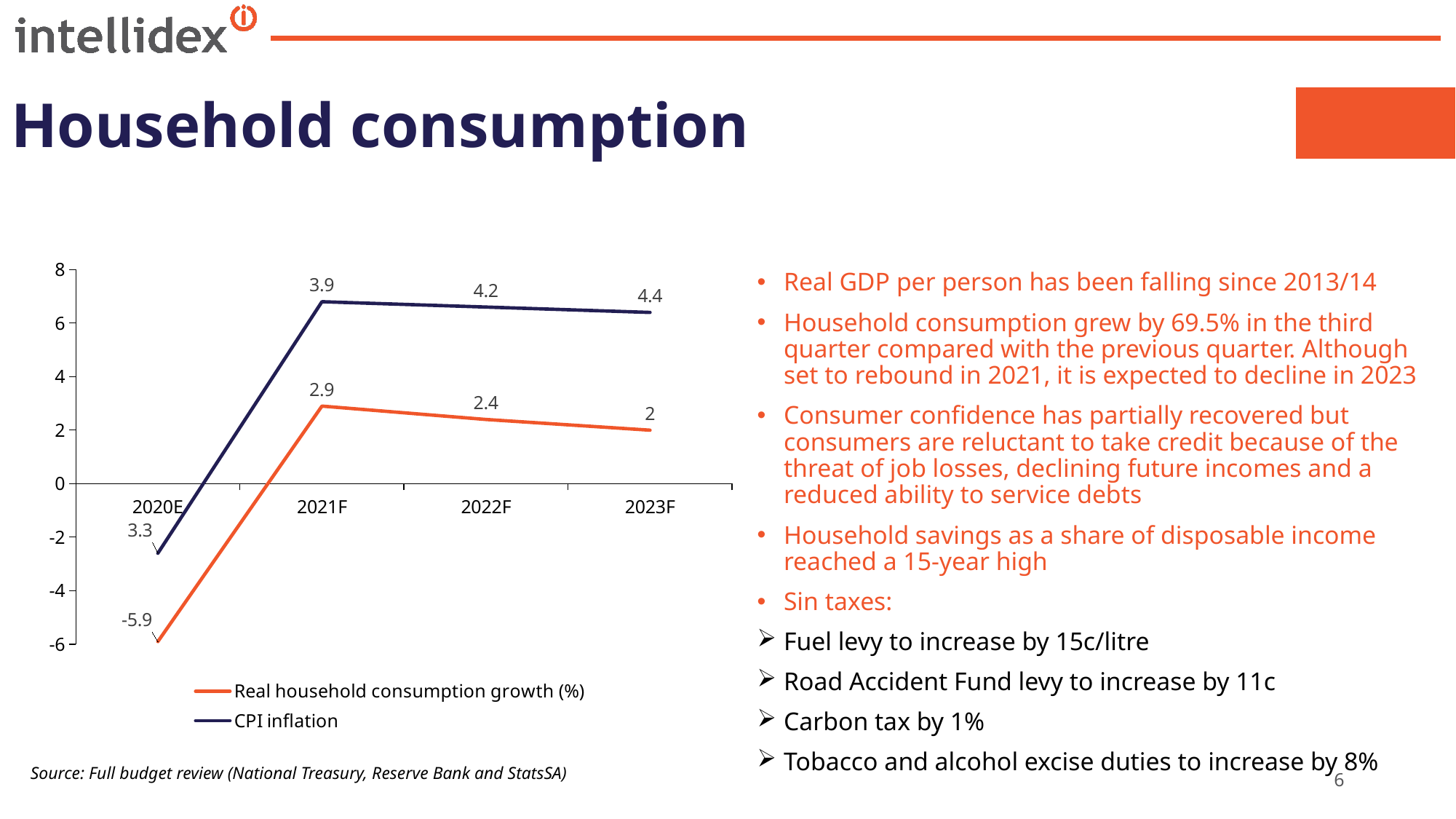
What is the CPI inflation value for 2022F? 4.2 In 2022F, which is larger: Real household consumption growth (%) or CPI inflation? CPI inflation How many series does the chart's legend list? 2 What is the difference between Real household consumption growth (%) in 2021F and 2023F? 0.9 In which year is Real household consumption growth (%) lowest? 2020E What is the Real household consumption growth (%) value for 2020E? -5.9 What is the Real household consumption growth (%) value for 2021F? 2.9 How many years are shown on the x axis of the chart? 4 Does Real household consumption growth (%) rise or fall from 2021F to 2023F? Fall What type of chart is shown on the slide? Line chart What is the CPI inflation value for 2023F? 4.4 In which year is Real household consumption growth (%) highest? 2021F